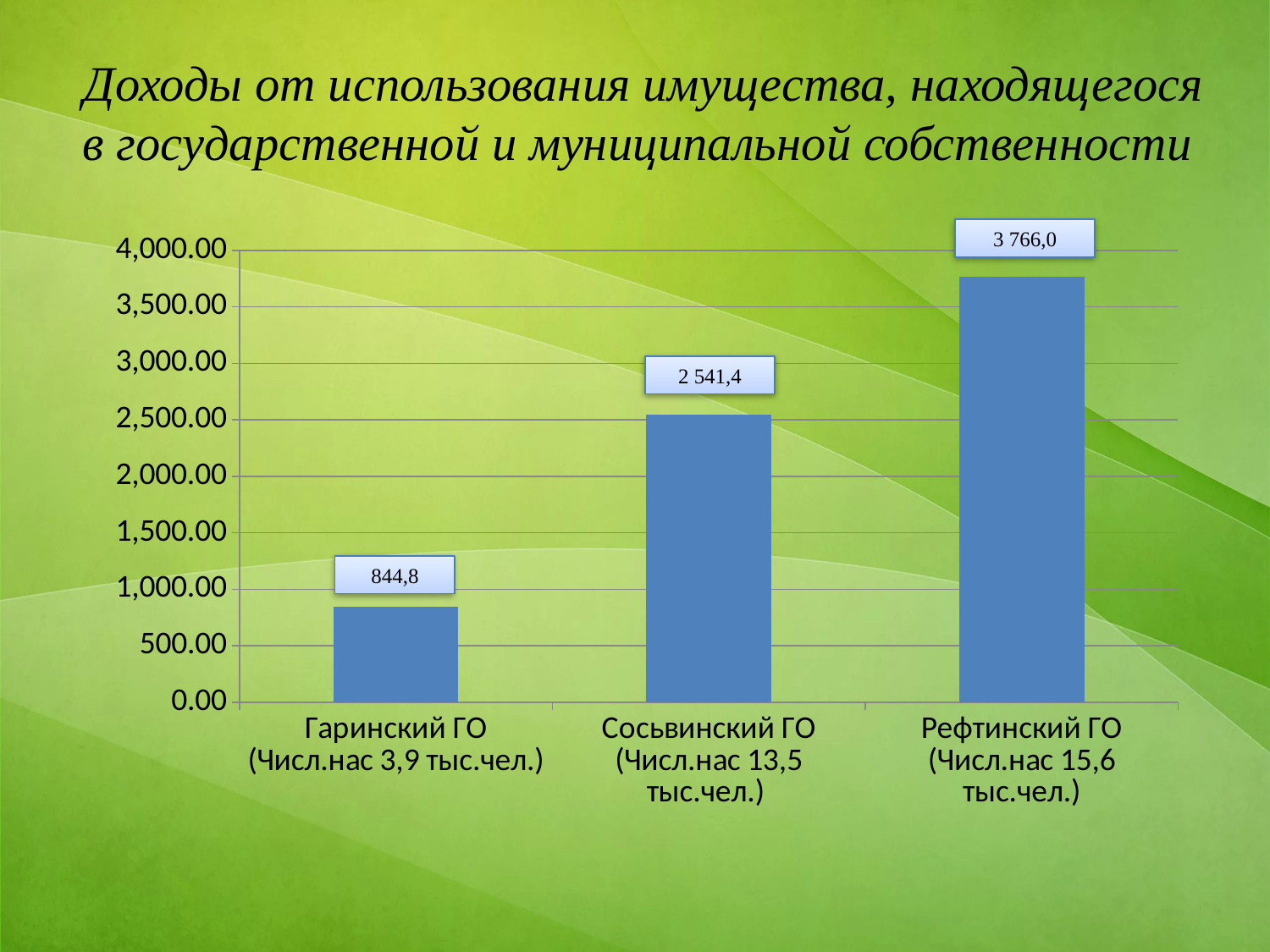
What is the difference between the values for Рефтинский ГО and Сосьвинский ГО? 1 224,6 Is the value for Гаринский ГО greater or less than 1,000.00? less How many categories are shown on the chart? 3 Do the values rise or fall from left to right along the x axis? rise What is the difference between the values for Рефтинский ГО and Гаринский ГО? 2 921,2 Which is larger, the value for Сосьвинский ГО or the value for Гаринский ГО? Сосьвинский ГО What is the value for Сосьвинский ГО? 2 541,4 Which category has the lowest value? Гаринский ГО Which category has the highest value? Рефтинский ГО What kind of chart is shown on the slide? bar chart What is the value for Гаринский ГО? 844,8 What is the value for Рефтинский ГО? 3 766,0